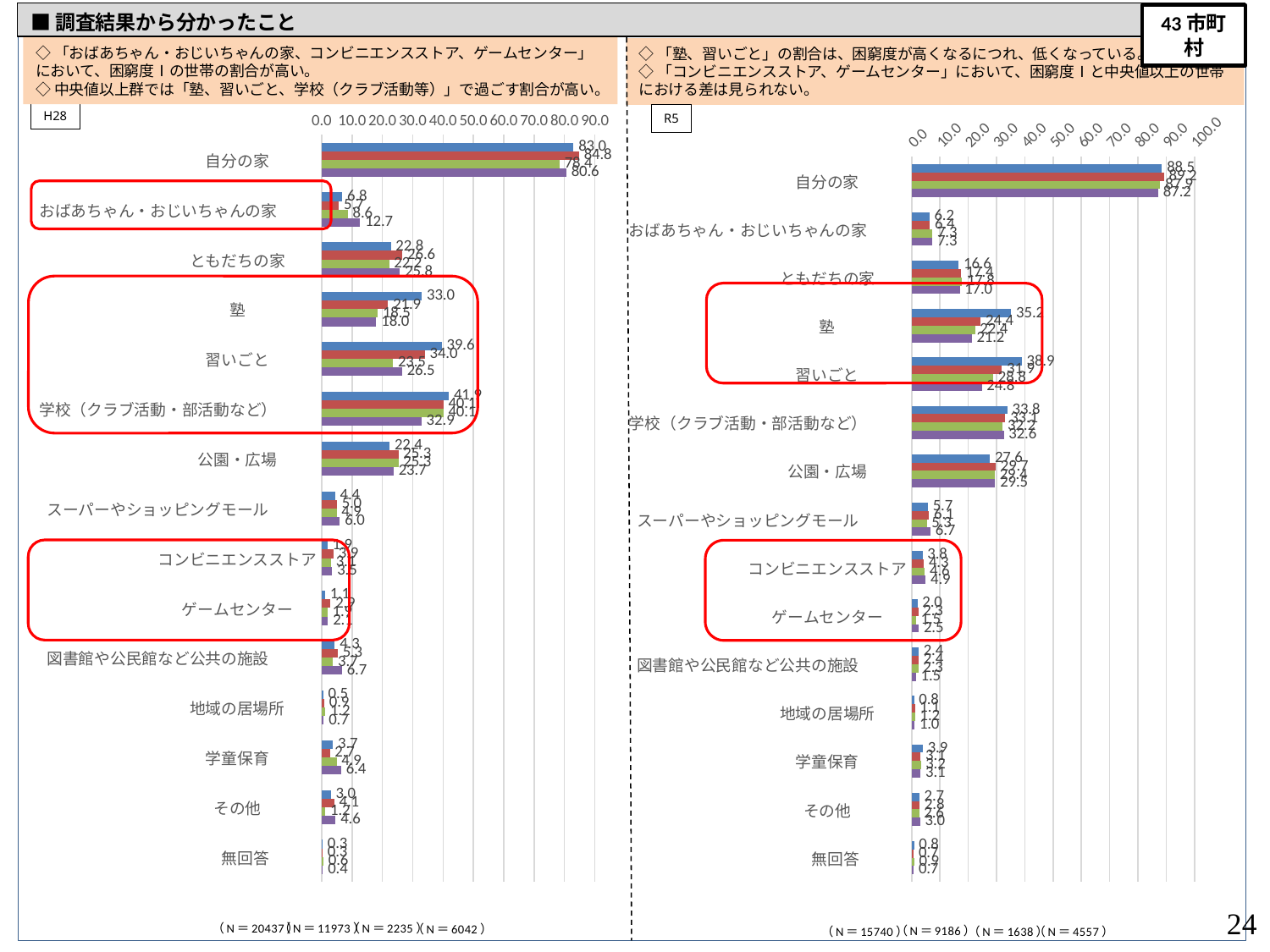
In the H28 chart on the left, what is the value of the blue (top) bar for 自分の家? 83.0 In the R5 chart on the right, what is the value of the purple (bottom) bar for 習いごと? 24.8 In the R5 chart on the right, which is larger for 公園・広場: the blue (top) bar or the purple (bottom) bar? the purple (bottom) bar How many categories are listed on the vertical axis of the R5 chart on the right? 15 In the H28 chart on the left, what is the value of the purple (bottom) bar for 塾? 18.0 In the H28 chart on the left, what is the value of the blue (top) bar for 習いごと? 39.6 In the H28 chart on the left, what is the difference between the blue (top) bar and the purple (bottom) bar for 塾? 15.0 In the R5 chart on the right, which category has the highest values? 自分の家 In the R5 chart on the right, what is the difference between the blue (top) bar and the purple (bottom) bar for 塾? 14.0 In the H28 chart on the left, is the blue (top) bar for 学校（クラブ活動・部活動など） greater or less than 40.0? greater In the R5 chart on the right, what is the value of the blue (top) bar for 自分の家? 88.5 What type of chart is the H28 chart on the left? bar chart